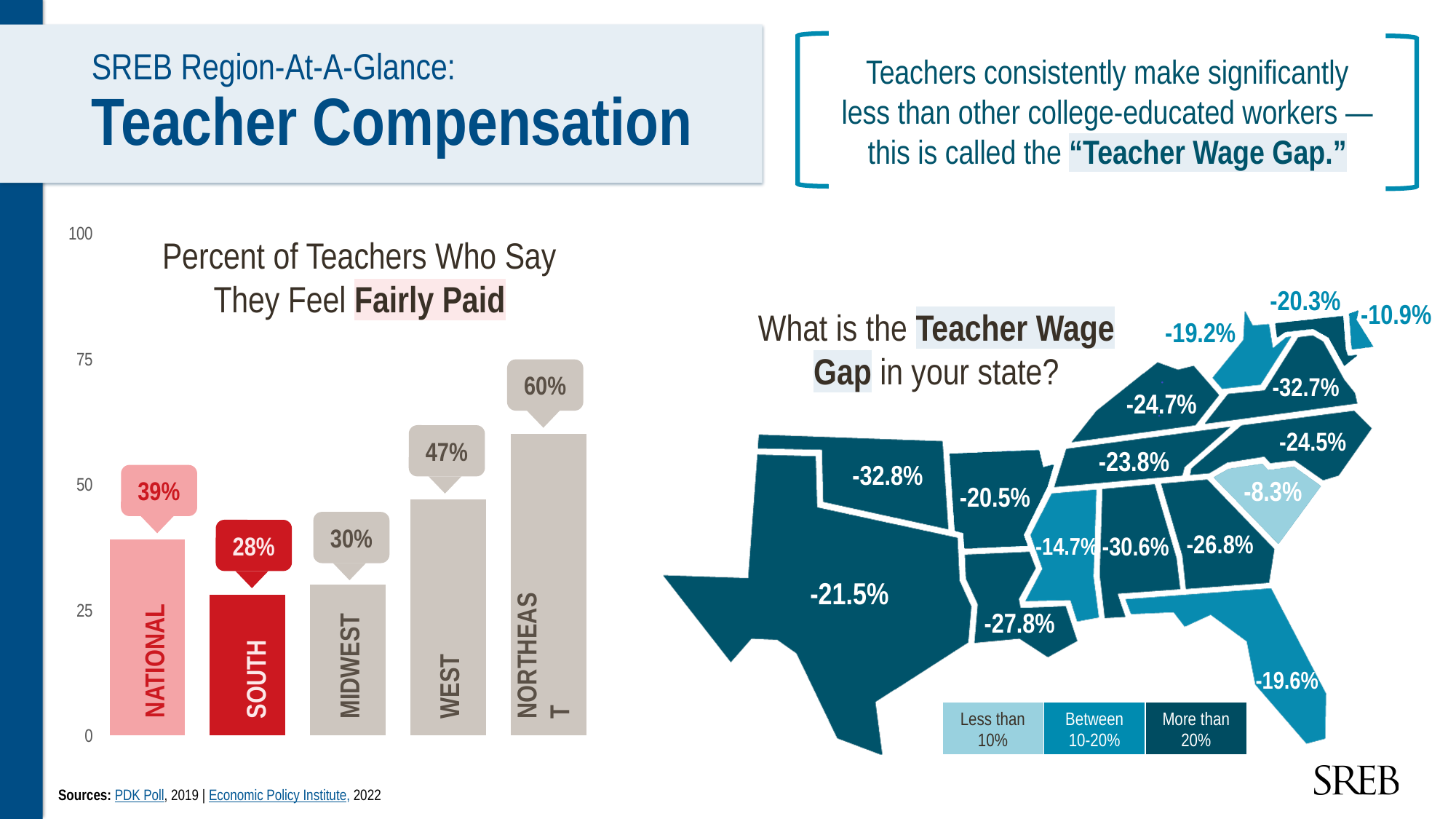
Which region has the highest percent of teachers who say they feel fairly paid? Northeast How many bars are shown in the bar chart? 5 Which region has the lowest percent of teachers who say they feel fairly paid? South In the bar chart, which is larger, the value for the West or the value for the Midwest? West What kind of chart is used to show the percent of teachers who say they feel fairly paid? bar chart In the bar chart, which bar is coloured red? South In the bar chart, what is the difference between the National and South values? 11% In the bar chart, what is the value for the Midwest? 30% In the bar chart, what percent of teachers in the South say they feel fairly paid? 28% In the bar chart, is the National value greater or less than 50? less In the bar chart, what is the value for the Northeast? 60% In the bar chart, what is the difference between the Northeast and South values? 32%